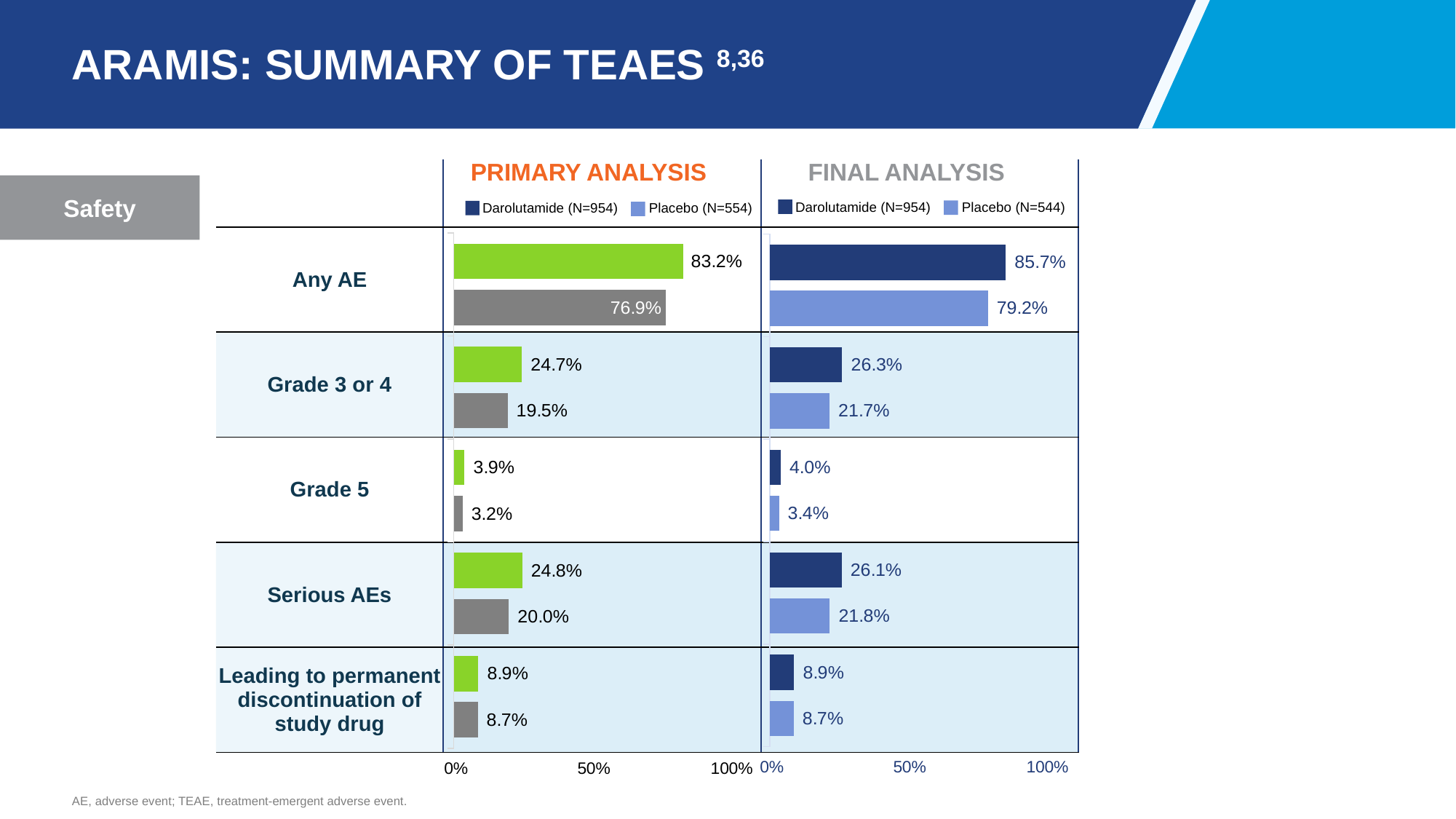
In the Final Analysis chart, which category has the lowest Placebo value? Grade 5 In the Final Analysis chart, what is the value for Darolutamide for Serious AEs? 26.1% What type of chart is the Primary Analysis chart? Bar chart In the Primary Analysis chart, what is the value for Darolutamide for Any AE? 83.2% In the Primary Analysis chart, what is the difference between the Darolutamide and Placebo values for Grade 3 or 4? 5.2% How many categories are shown in the Final Analysis chart? 5 In the Primary Analysis chart, which category has the highest Darolutamide value? Any AE In the Final Analysis chart, what is the difference between the Darolutamide and Placebo values for Any AE? 6.5% How many series does the legend of the Final Analysis chart list? 2 In the Primary Analysis chart, what is the value for Placebo for Grade 5? 3.2% In the Primary Analysis chart, which is larger for Serious AEs: Darolutamide or Placebo? Darolutamide In the Final Analysis chart, what is the value for Placebo for Any AE? 79.2%